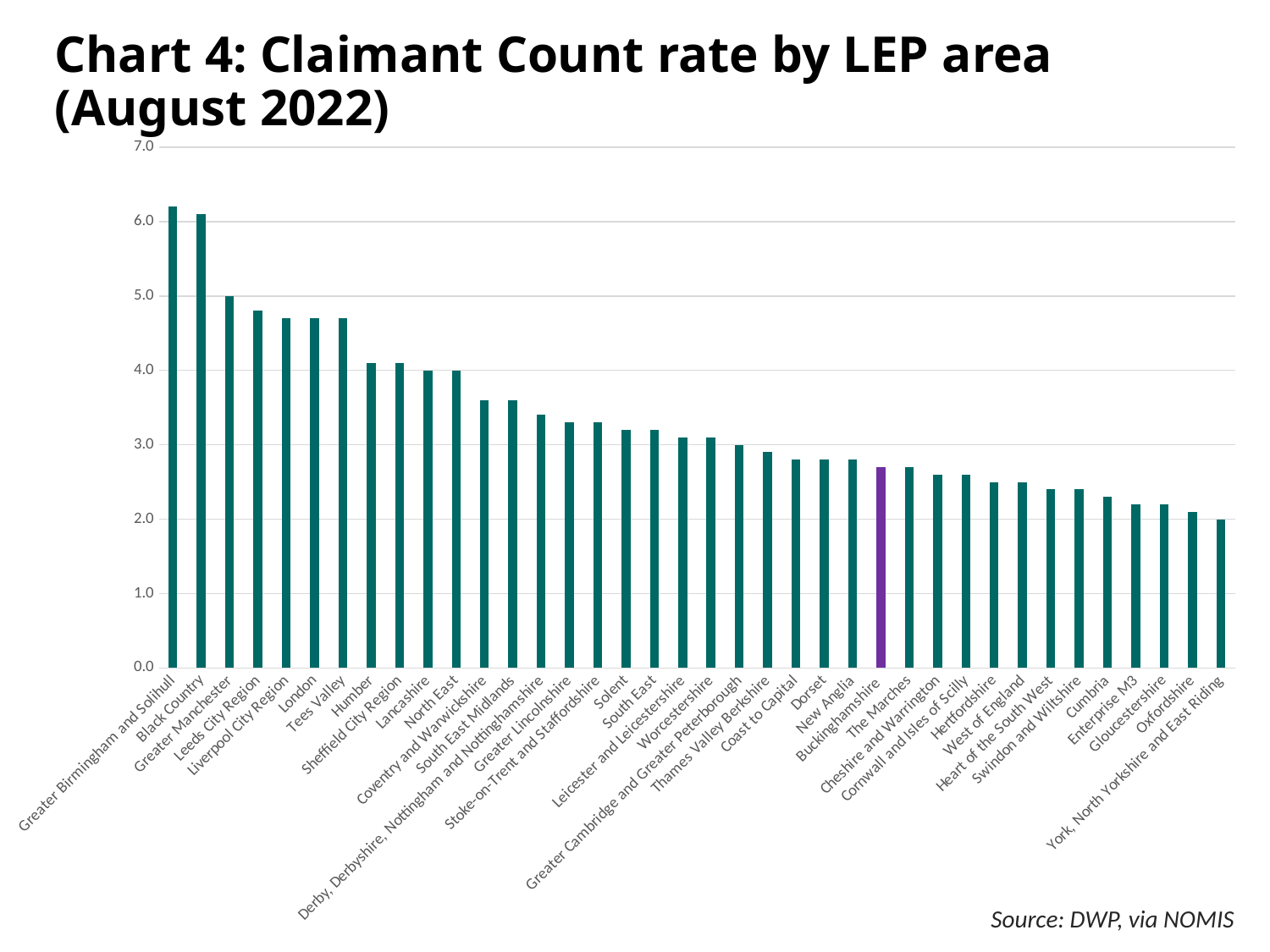
Which has the larger Claimant Count rate, Solent or Oxfordshire? Solent Which LEP area has the lowest Claimant Count rate? York, North Yorkshire and East Riding Is the value for London greater or less than 4.0? greater Which has the larger Claimant Count rate, Black Country or Greater Manchester? Black Country How many LEP areas are plotted in the chart? 38 Is the value for Tees Valley greater or less than 4.0? greater Is the value for Humber greater or less than 5.0? less Which LEP area has the highest Claimant Count rate? Greater Birmingham and Solihull What kind of chart is shown on the slide? Bar chart Which LEP area's bar is shown in a different colour (purple) from the others? Buckinghamshire Do the values rise or fall moving from left to right along the x axis? Fall